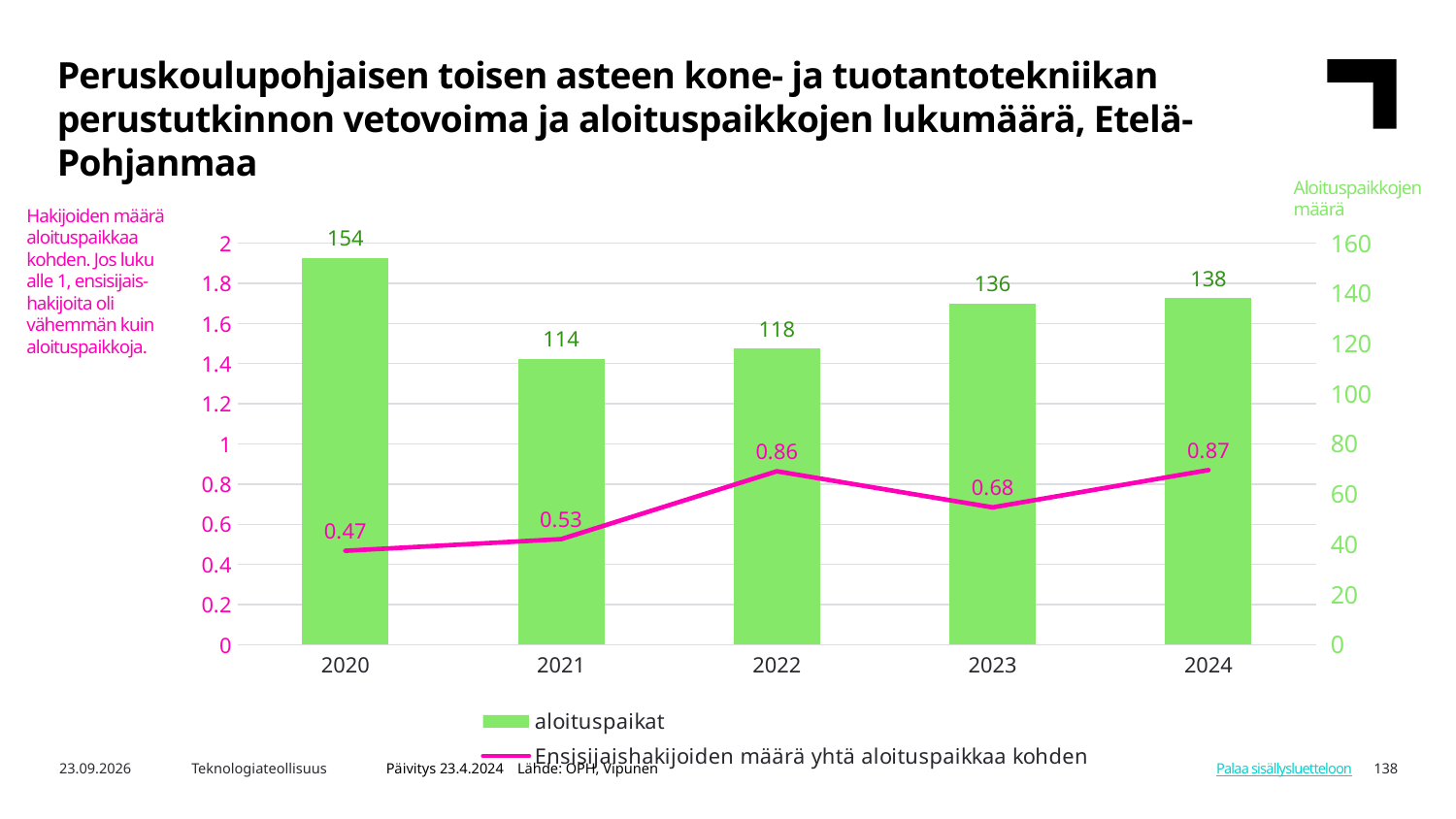
What is the value of aloituspaikat for 2023? 136 Which year has the lowest value of aloituspaikat? 2021 What is the value of aloituspaikat for 2020? 154 What is the difference in aloituspaikat between 2020 and 2021? 40 Which year has the lowest value of Ensisijaishakijoiden määrä yhtä aloituspaikkaa kohden? 2020 Which year has the larger value of Ensisijaishakijoiden määrä yhtä aloituspaikkaa kohden, 2022 or 2023? 2022 Which year has the highest value of aloituspaikat? 2020 How many years are shown on the x axis of the chart? 5 How many series does the chart legend list? 2 Which series is drawn as a line in the chart? Ensisijaishakijoiden määrä yhtä aloituspaikkaa kohden What is the value of Ensisijaishakijoiden määrä yhtä aloituspaikkaa kohden for 2022? 0.86 Does the value of Ensisijaishakijoiden määrä yhtä aloituspaikkaa kohden rise or fall from 2020 to 2022? rise